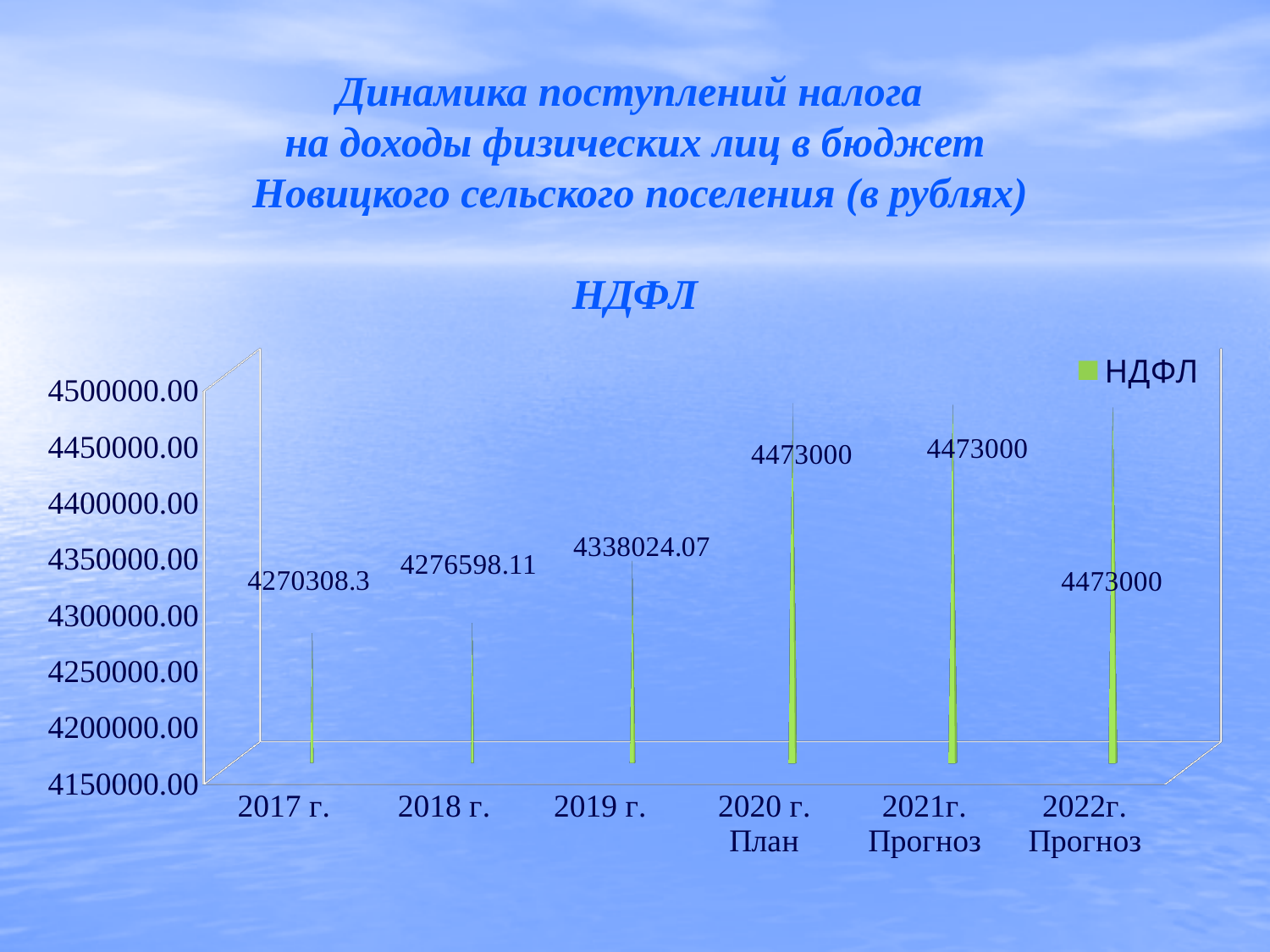
Do the values rise or fall from 2017 г. to 2020 г. План? rise What is the value for 2019 г.? 4338024.07 What is the value for 2021г. Прогноз? 4473000 What is the value for 2017 г.? 4270308.3 Which is larger, the value for 2019 г. or the value for 2018 г.? 2019 г. What is the difference between the values for 2020 г. План and 2019 г.? 134975.93 What kind of chart is shown? bar chart What is the difference between the values for 2019 г. and 2018 г.? 61425.96 How many series does the legend list? 1 Which category has the lowest value? 2017 г. Is the value for 2017 г. greater or less than 4300000.00? less How many categories are shown on the x axis? 6